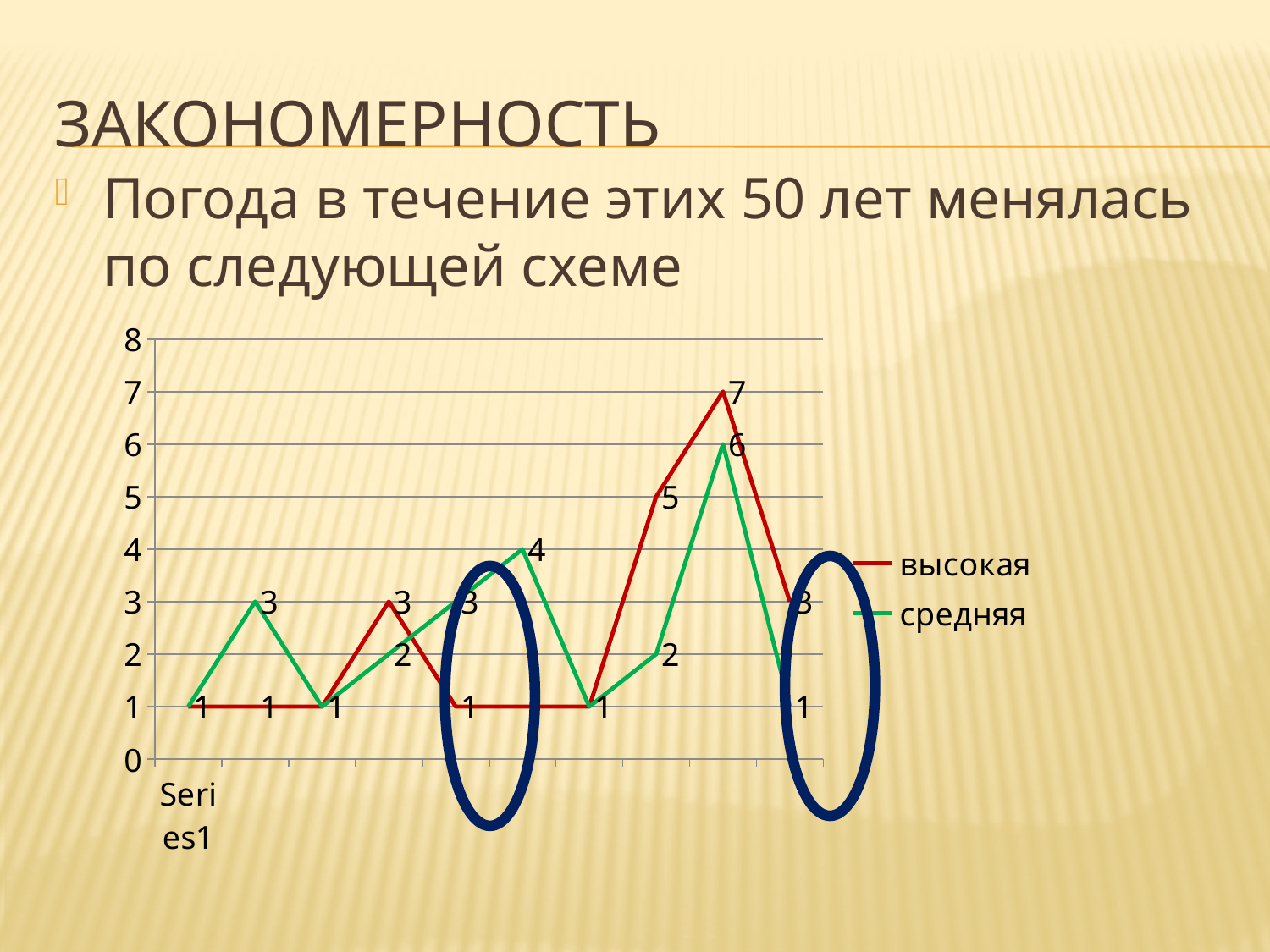
What is the lowest value reached by the series "высокая"? 1 What is the value of the series "высокая" at the last point on the right? 3 Which colour is used for the series "высокая"? red What is the value of the series "средняя" at the first point (labelled Series1)? 1 What is the lowest value reached by the series "средняя"? 1 What is the highest value reached by the series "высокая"? 7 What are the two series named in the legend? высокая and средняя Which series reaches the higher peak value, "высокая" or "средняя"? высокая What is the highest value reached by the series "средняя"? 6 What is the difference between the peak value of "высокая" and the peak value of "средняя"? 1 What kind of chart is shown on the slide? line chart How many series does the legend list? 2